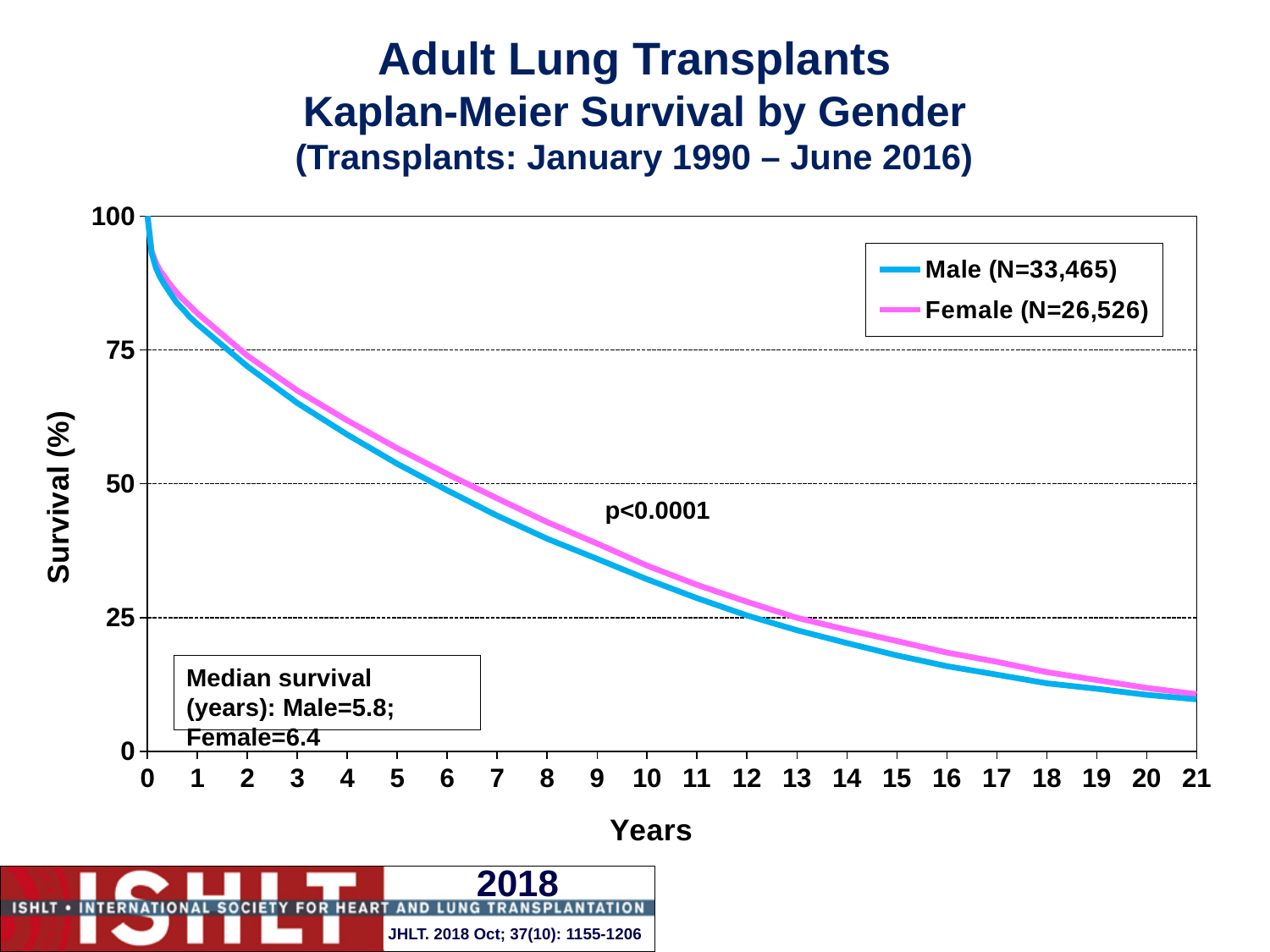
What is the difference in median survival (years) between females and males? 0.6 What is the median survival in years for females, as stated on the slide? 6.4 What is the median survival in years for males, as stated on the slide? 5.8 Do the survival curves rise or fall as years increase along the x axis? fall Which curve shows higher survival at 10 years, Male or Female? Female How many series does the legend list? 2 What p-value is printed on the chart? p<0.0001 What is the N for the Female group shown in the legend? 26,526 Is the Male survival value at 10 years greater or less than 50? less What kind of chart is shown on the slide? line chart What is the N for the Male group shown in the legend? 33,465 Is the Female survival value at 5 years greater or less than 50? greater